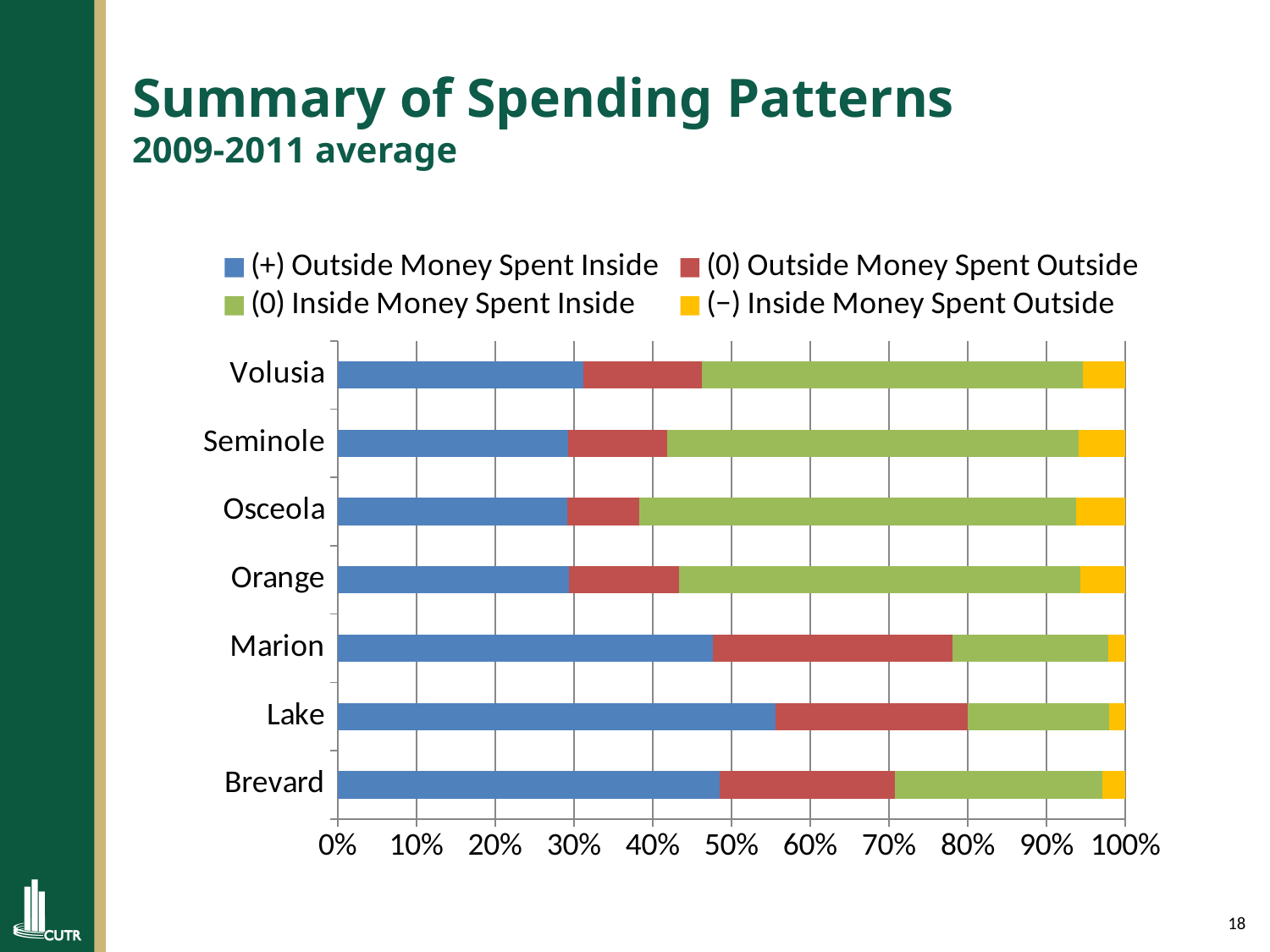
Is the (+) Outside Money Spent Inside share for Lake greater or less than 50%? greater Which county has the largest share for (+) Outside Money Spent Inside? Lake Is the (0) Outside Money Spent Outside share for Marion greater or less than 20%? greater Which county has the largest share for (0) Outside Money Spent Outside? Marion What is the title of the chart's slide? Summary of Spending Patterns Which county has a larger (+) Outside Money Spent Inside share, Lake or Marion? Lake Which legend entry is shown in yellow? (−) Inside Money Spent Outside How many series does the chart's legend list? 4 What kind of chart is shown on the slide? Bar chart Is the (+) Outside Money Spent Inside share for Volusia greater or less than 40%? less Which county has a larger (0) Outside Money Spent Outside share, Volusia or Osceola? Volusia How many counties are listed on the chart's vertical axis? 7